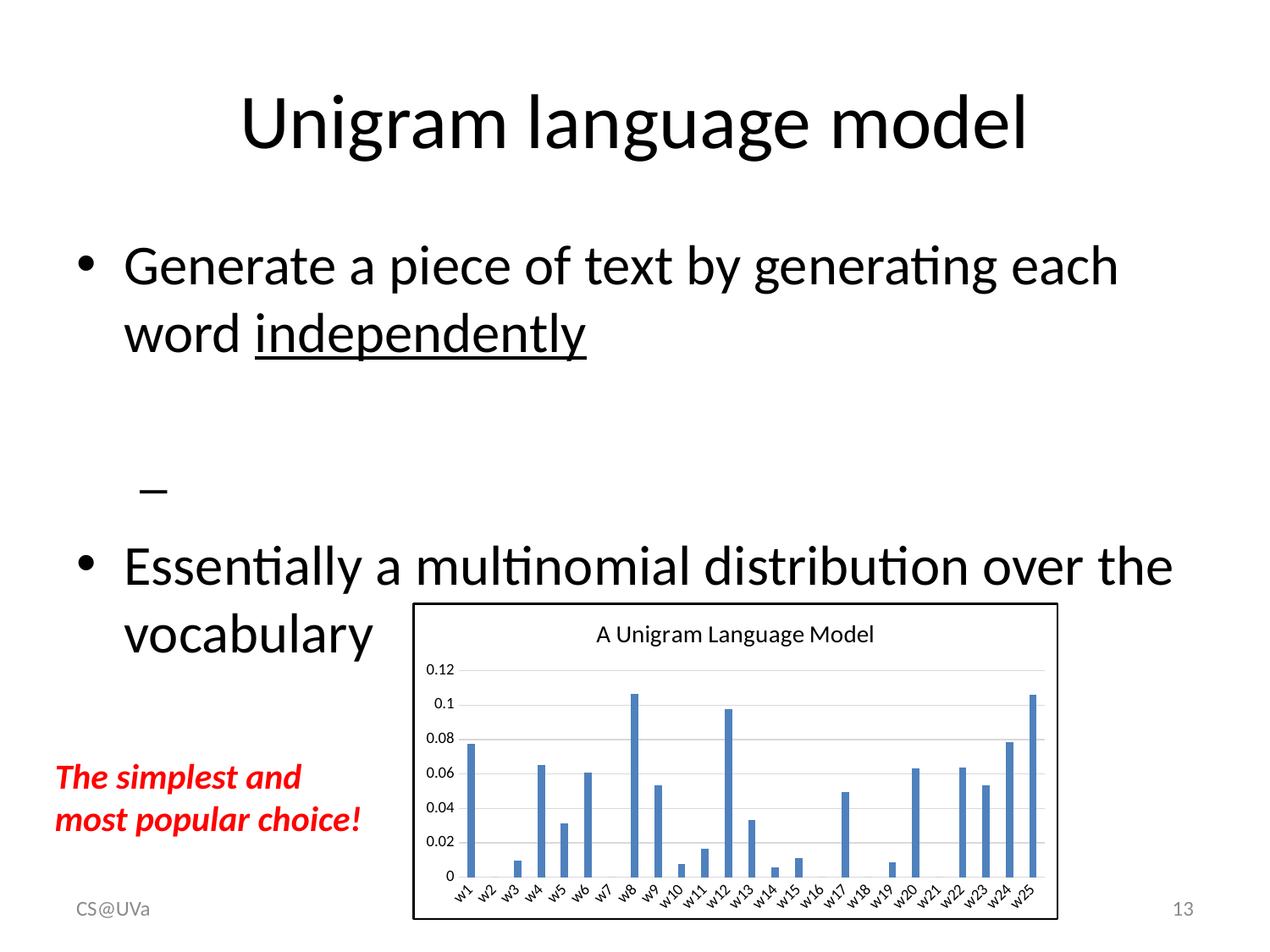
Which has the larger value, w8 or w12? w8 What is the title of the chart on the slide? A Unigram Language Model Is the value for w17 greater or less than 0.06? less What kind of chart is shown on the slide? bar chart Which has the larger value, w1 or w5? w1 What is the highest value shown on the y axis of the chart? 0.12 Is the value for w14 greater or less than 0.02? less Is the value for w8 greater or less than 0.1? greater How many words (categories) are shown on the x axis of the chart? 25